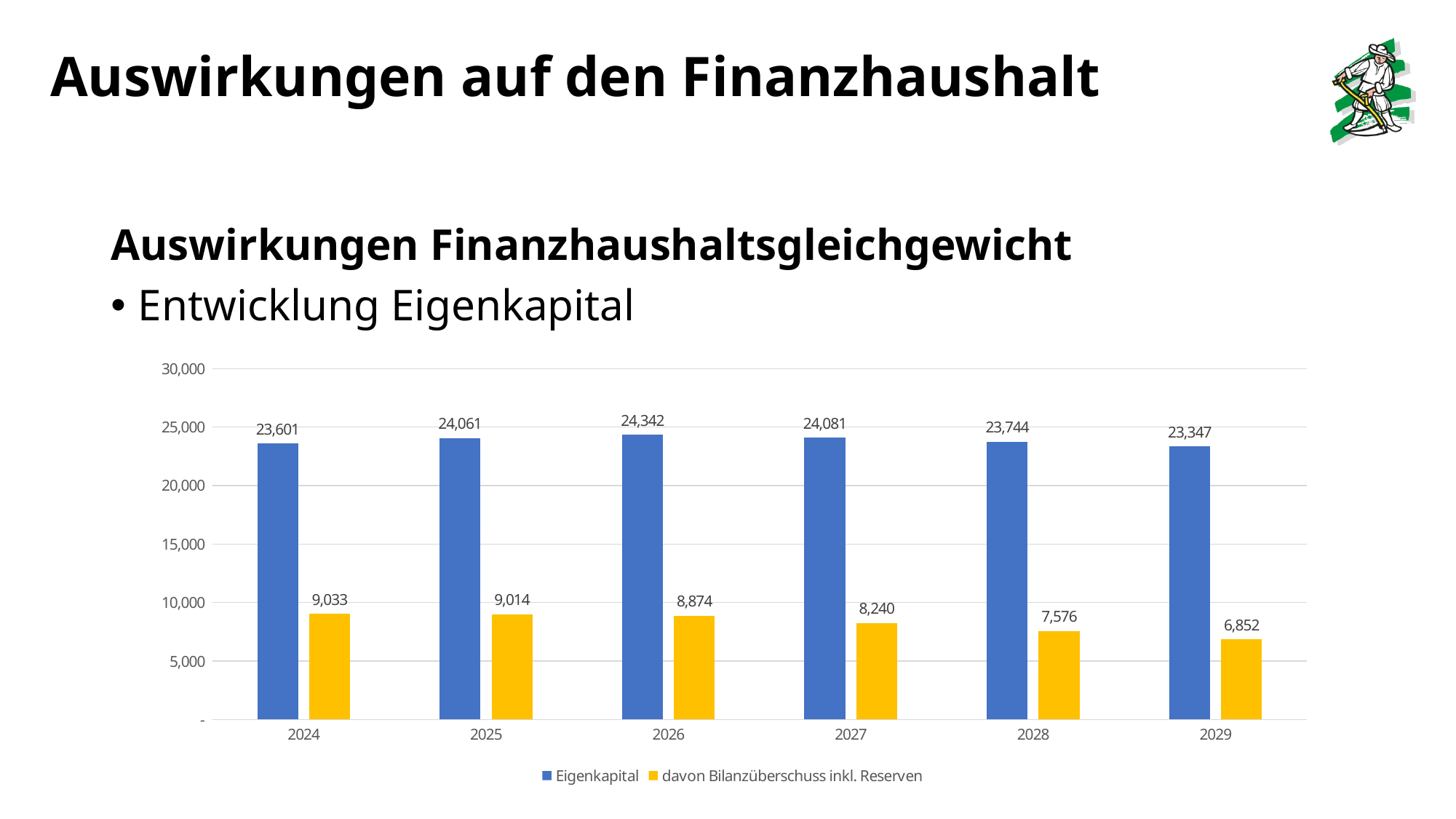
How many years are shown on the x axis? 6 In which year is Eigenkapital highest? 2026 What is the difference between Eigenkapital in 2026 and in 2029? 995 Does 'davon Bilanzüberschuss inkl. Reserven' rise or fall from 2024 to 2029? fall What is the value of 'davon Bilanzüberschuss inkl. Reserven' for 2029? 6,852 How many series does the legend list? 2 What is the Eigenkapital value for 2026? 24,342 In which year is 'davon Bilanzüberschuss inkl. Reserven' lowest? 2029 Is the Eigenkapital value for 2024 greater or less than 20,000? greater What kind of chart is shown on the slide? bar chart Which is larger: Eigenkapital in 2025 or Eigenkapital in 2027? 2027 What is the difference between 'davon Bilanzüberschuss inkl. Reserven' in 2024 and in 2028? 1,457